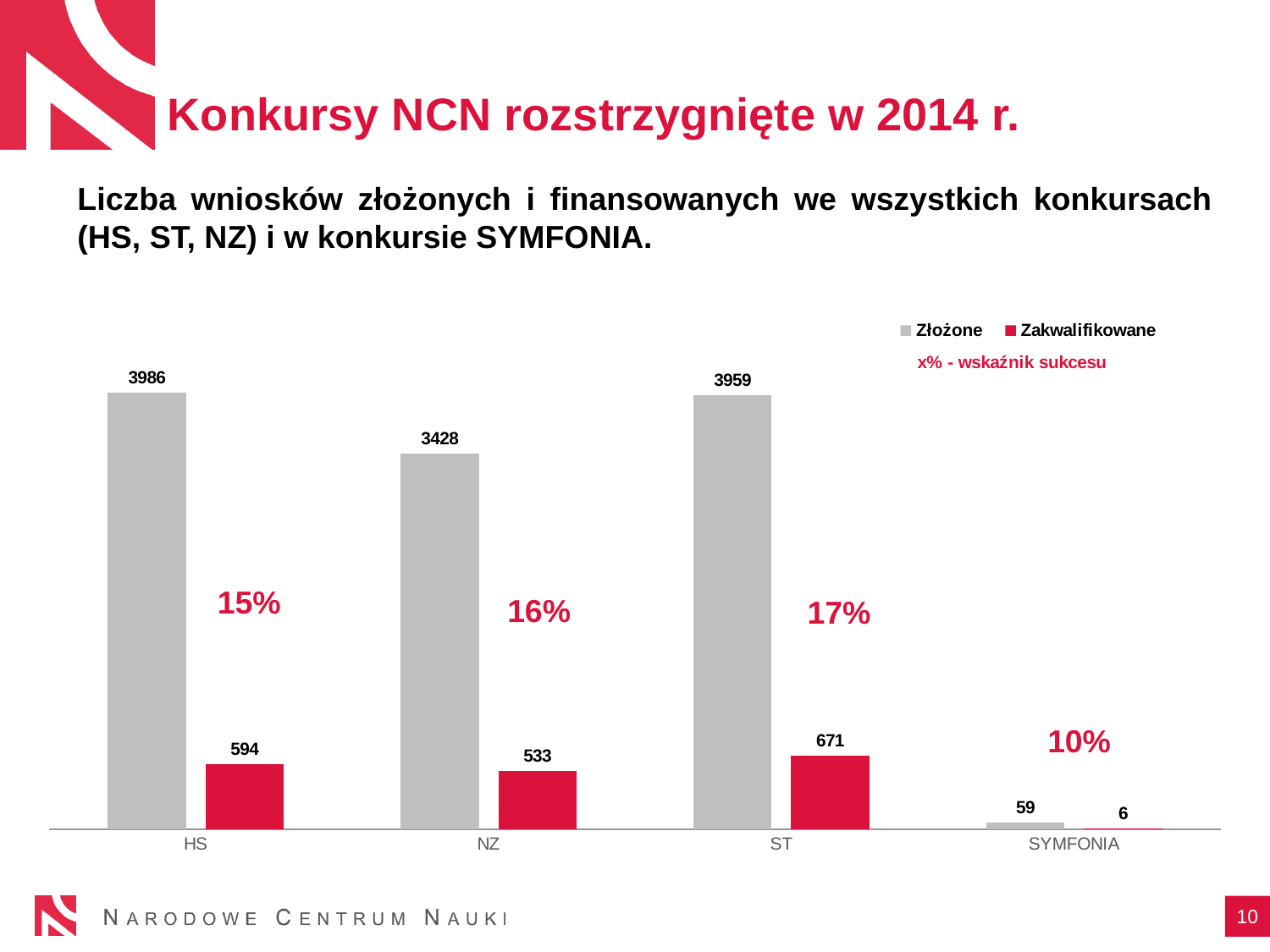
What is the value of Złożone for SYMFONIA? 59 What kind of chart is shown? bar chart What is the value of Złożone for HS? 3986 Which category has the highest Złożone value? HS How many series does the legend list? 2 What is the value of Zakwalifikowane for ST? 671 What is the difference between Złożone and Zakwalifikowane for HS? 3392 What success rate (wskaźnik sukcesu) is shown for SYMFONIA? 10% What is the value of Zakwalifikowane for NZ? 533 Which category has the lowest Zakwalifikowane value? SYMFONIA Which is larger, Zakwalifikowane for HS or Zakwalifikowane for NZ? HS How many categories are shown on the x axis? 4